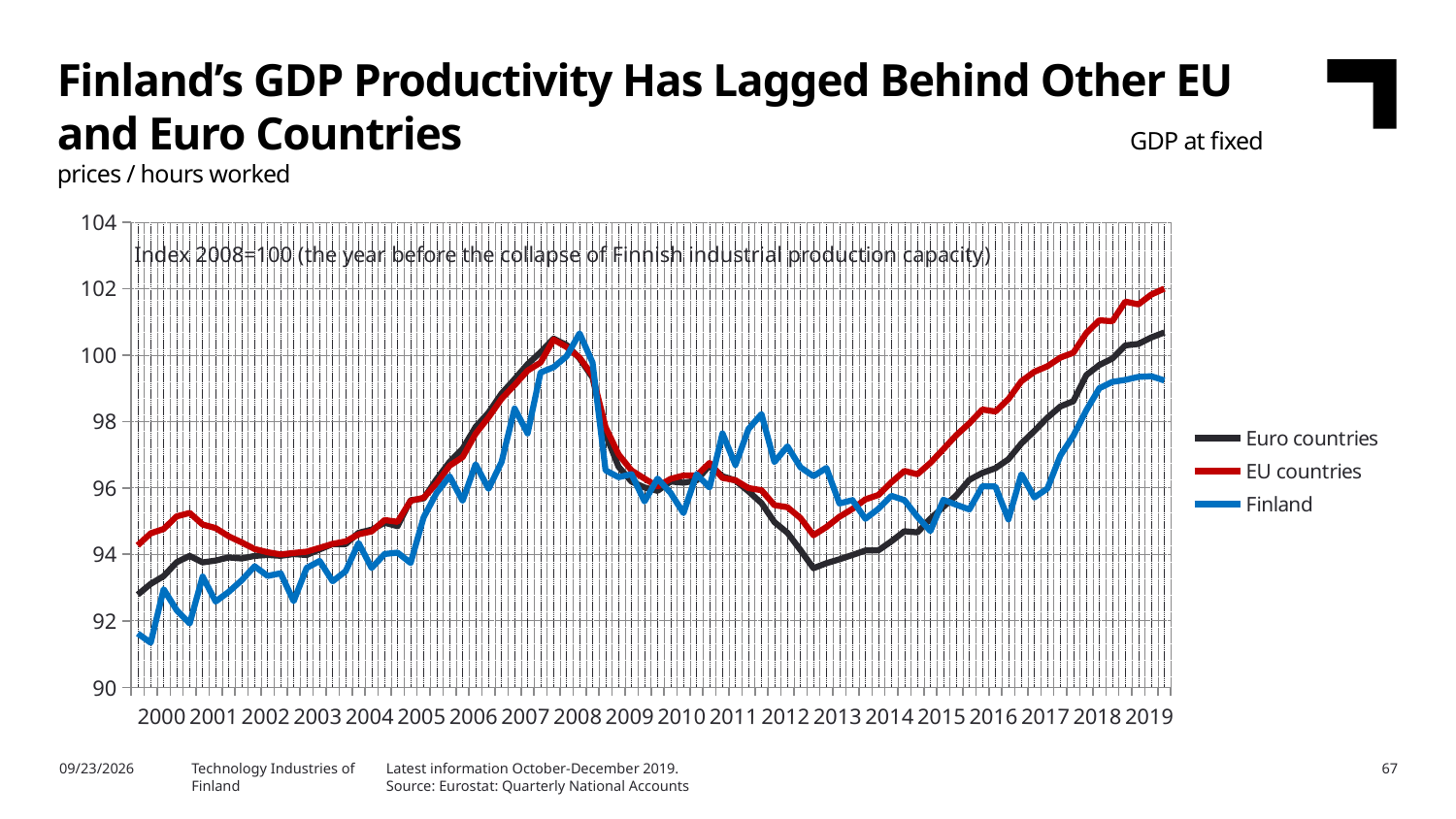
Which series has the highest value at the end of 2019? EU countries Is the value for EU countries at the end of 2019 greater or less than 100? greater How many years are labelled on the x axis? 20 Which series has the lowest value at the start of 2000? Finland How many series does the legend list? 3 Which series is drawn in blue? Finland Is the value for Finland at the end of 2019 greater or less than 100? less Is the value for Finland at the start of 2000 greater or less than 92? less What kind of chart is shown on the slide? line chart What base year is the index set to 100? 2008 In 2013, which is higher: Finland or Euro countries? Finland